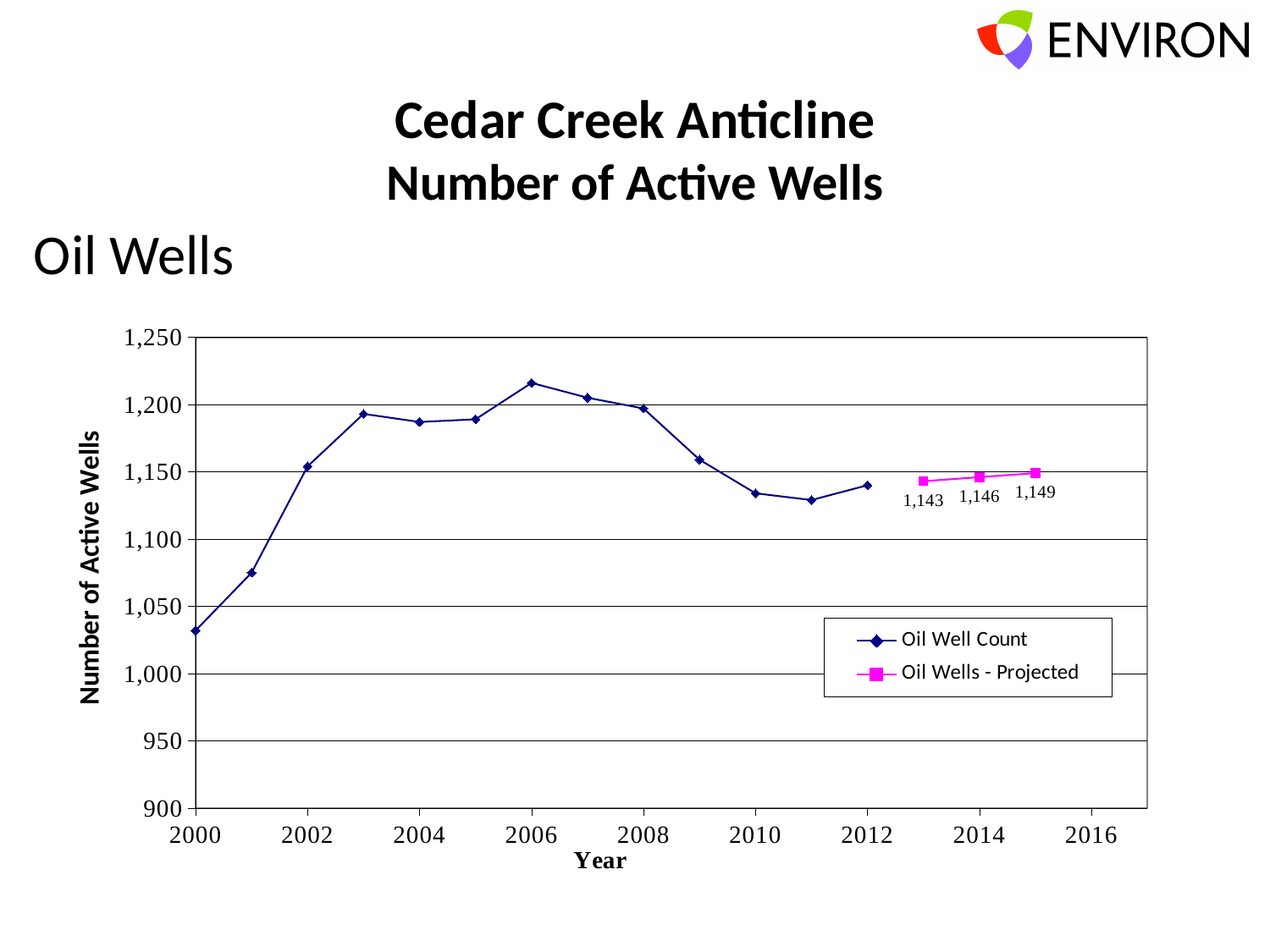
What is the projected number of oil wells for 2015? 1,149 Is the Oil Well Count for 2000 greater or less than 1,050? less How many series does the legend list? 2 Which year has the larger Oil Well Count, 2001 or 2002? 2002 What is the projected number of oil wells for 2013? 1,143 How many data points are plotted for the Oil Wells - Projected series? 3 Is the Oil Well Count for 2006 greater or less than 1,200? greater What kind of chart is shown on the slide? line chart Do the Oil Wells - Projected values rise or fall from 2013 to 2015? rise What is the difference between the projected oil well values for 2015 and 2013? 6 In which year is the Oil Well Count lowest? 2000 In which year is the Oil Well Count highest? 2006